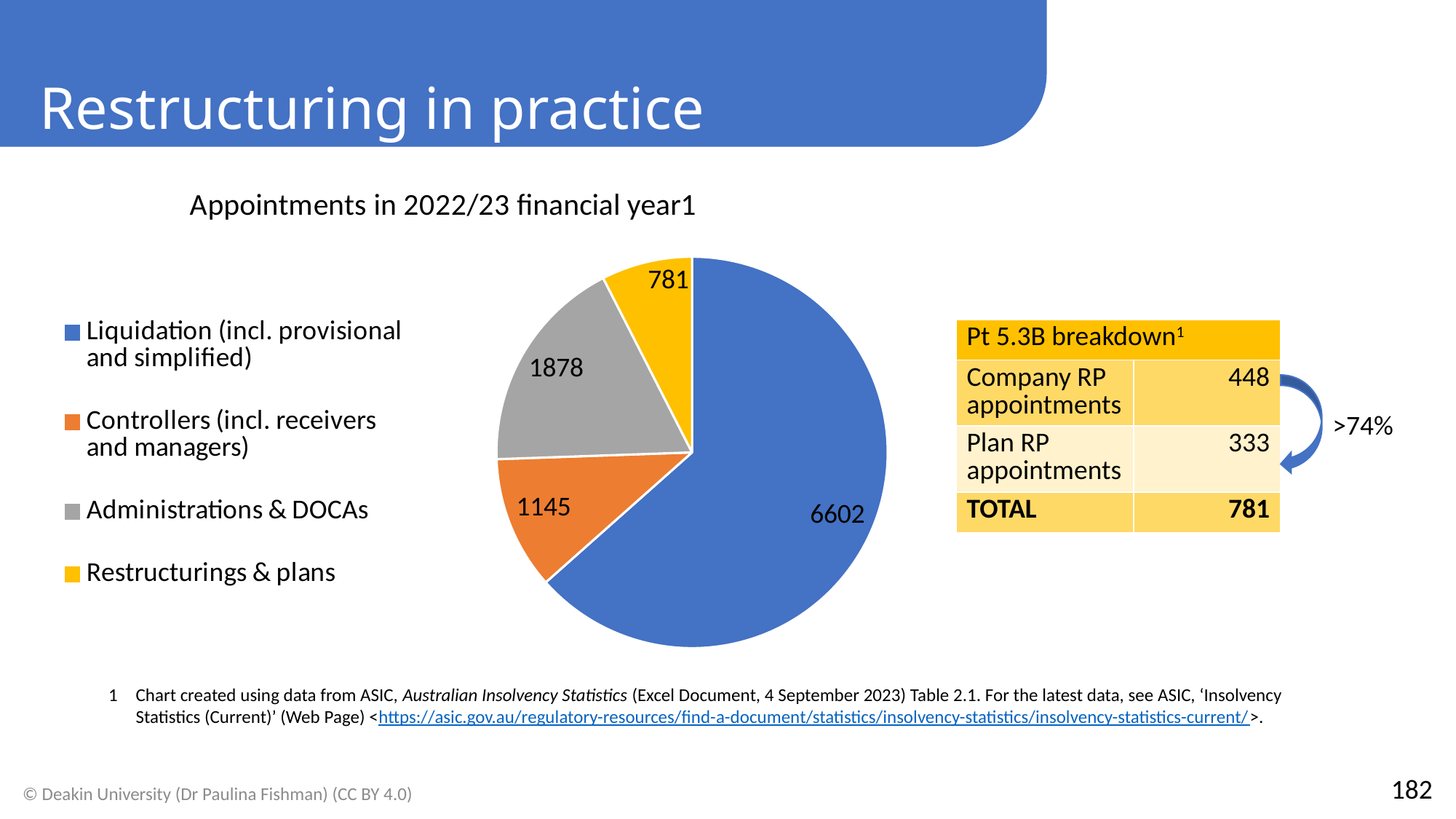
What is the value for Administrations & DOCAs in the pie chart? 1878 What is the value for Controllers (incl. receivers and managers) in the pie chart? 1145 What is the title of the pie chart? Appointments in 2022/23 financial year1 What is the value for Restructurings & plans in the pie chart? 781 Which category has the smallest slice in the pie chart? Restructurings & plans What is the total of all four slices in the pie chart? 10406 Which category has the largest slice in the pie chart? Liquidation (incl. provisional and simplified) What kind of chart is shown on the slide? Pie chart Which is larger in the pie chart: Controllers (incl. receivers and managers) or Restructurings & plans? Controllers (incl. receivers and managers) What is the value for Liquidation (incl. provisional and simplified) in the pie chart? 6602 What is the difference between the values for Administrations & DOCAs and Controllers (incl. receivers and managers)? 733 How many categories does the pie chart show? 4